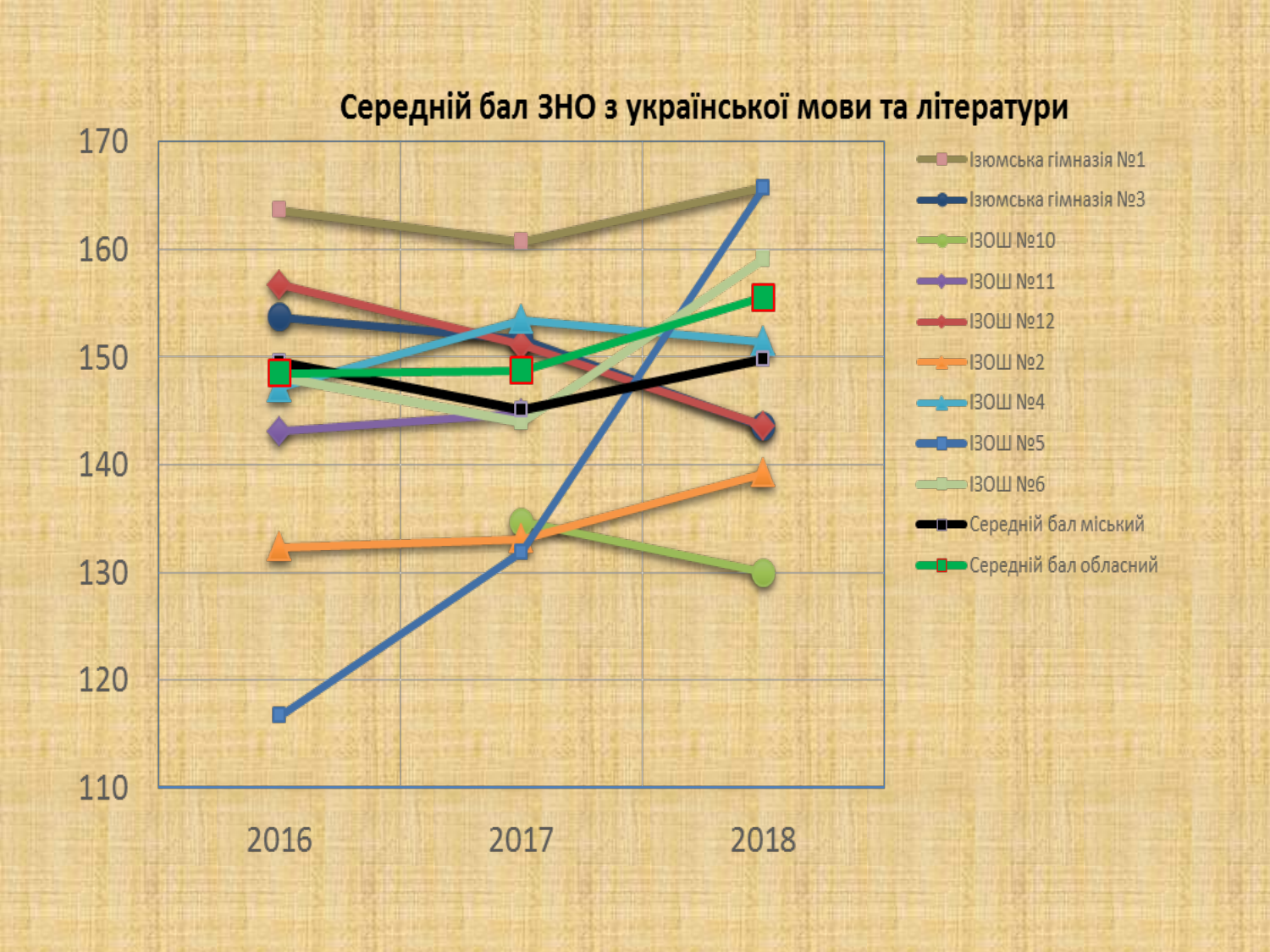
Is the value for Ізюмська гімназія №1 in 2016 greater or less than 160? greater What kind of chart is shown on the slide? line chart Which series has the highest value in 2016? Ізюмська гімназія №1 Is the value for ІЗОШ №5 in 2016 greater or less than 120? less Does the value for ІЗОШ №5 rise or fall from 2016 to 2018? rises Does the value for ІЗОШ №10 rise or fall from 2016 to 2018? falls Which series has the lowest value in 2016? ІЗОШ №5 What is the title of the chart? Середній бал ЗНО з української мови та літератури In 2017, which is larger: the value for Ізюмська гімназія №1 or the value for ІЗОШ №2? Ізюмська гімназія №1 How many series does the legend list? 11 Which series has the lowest value in 2018? ІЗОШ №10 How many years are shown on the x axis? 3